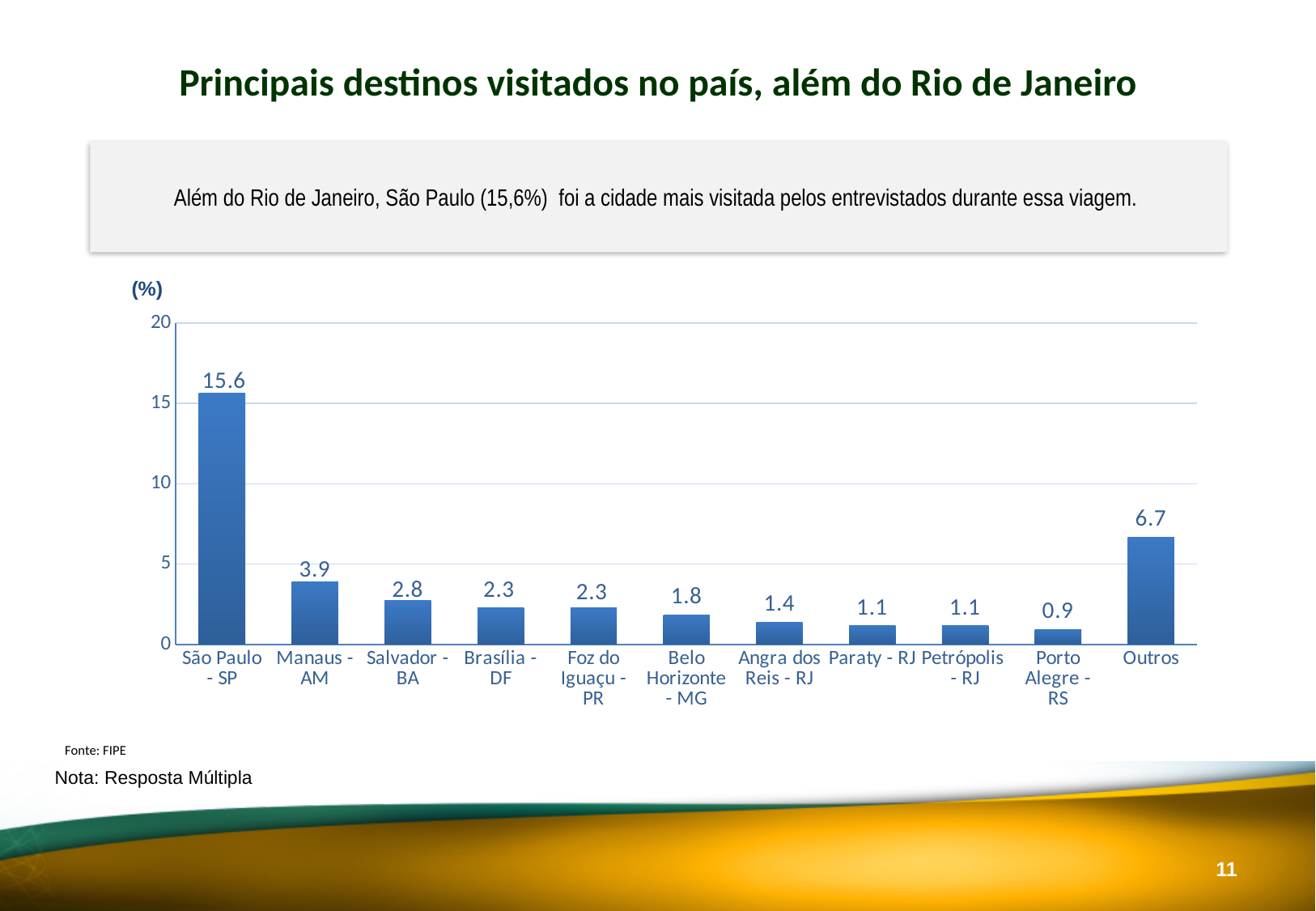
Which is larger, the value for Salvador - BA or the value for Angra dos Reis - RJ? Salvador - BA What is the difference between the values for Outros and Manaus - AM? 2.8 What is the difference between the values for São Paulo - SP and Manaus - AM? 11.7 What is the value for Manaus - AM? 3.9 What is the value for São Paulo - SP? 15.6 What is the value for Belo Horizonte - MG? 1.8 Which category has the lowest value? Porto Alegre - RS Is the value for Outros greater or less than 5? greater Which category has the highest value? São Paulo - SP What kind of chart is shown on the slide? bar chart How many categories are shown on the x axis? 11 What is the value for Outros? 6.7